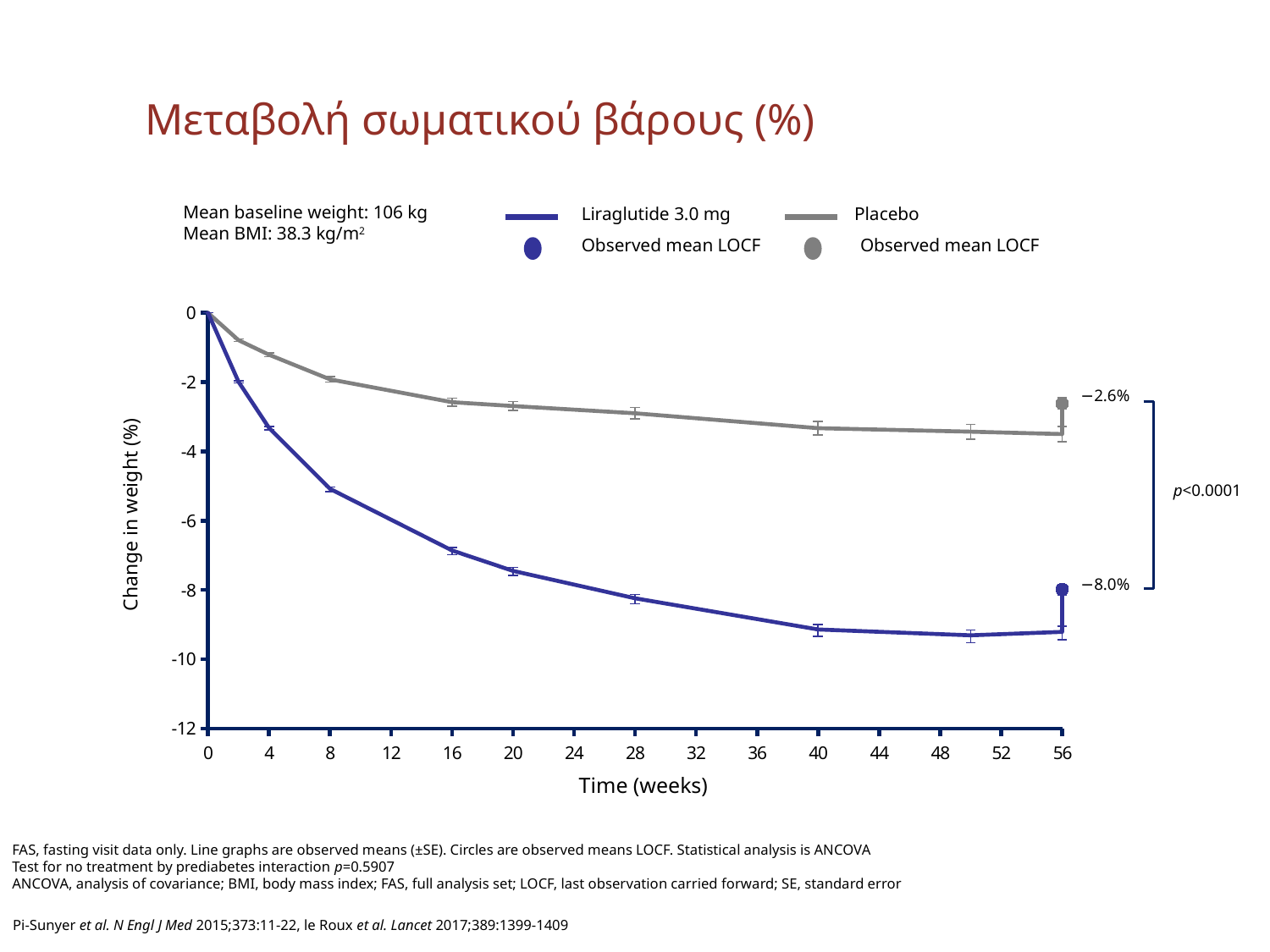
Which treatment group shows the greater weight loss at week 56? Liraglutide 3.0 mg What is the difference between the week-56 observed mean LOCF values for Liraglutide 3.0 mg (−8.0%) and Placebo (−2.6%)? 5.4 percentage points Is the Placebo line value at week 56 greater or less than −4? greater Is the Liraglutide 3.0 mg line value at week 56 greater or less than −8? less What p-value is shown for the comparison between the two groups at week 56? p<0.0001 How many treatment groups are plotted on the chart? 2 What is the observed mean LOCF change in weight at week 56 for Liraglutide 3.0 mg? −8.0% Do the plotted change-in-weight values rise or fall as time in weeks increases? fall What is the observed mean LOCF change in weight at week 56 for Placebo? −2.6% What kind of chart is shown on the slide? line chart Is the Liraglutide 3.0 mg line value at week 8 greater or less than −4? less Which treatment group reaches the lowest (most negative) change in weight on the chart? Liraglutide 3.0 mg